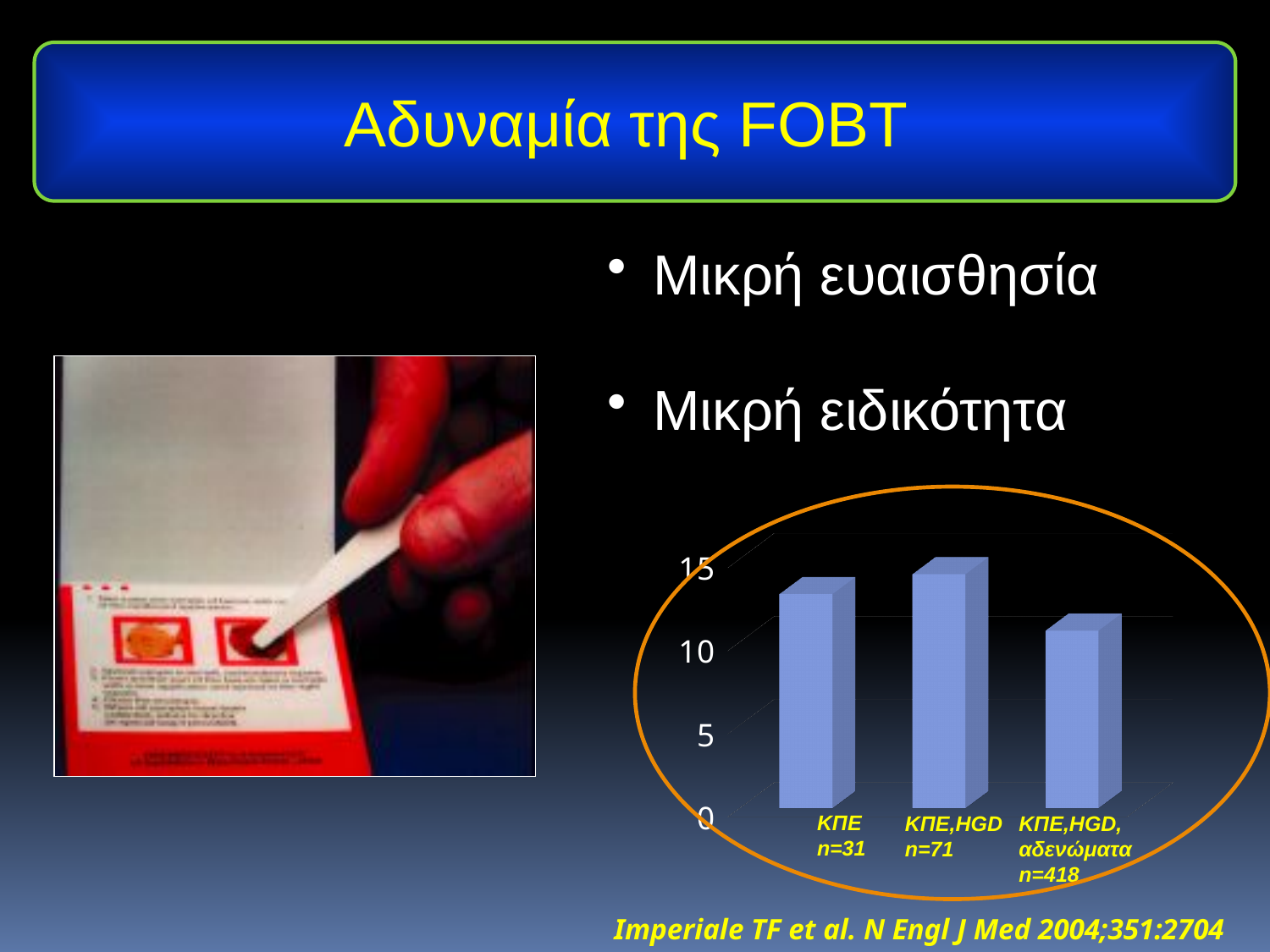
Is the value for ΚΠΕ n=31 greater or less than 10? greater Which is larger, the value for ΚΠΕ,HGD n=71 or the value for ΚΠΕ,HGD, αδενώματα n=418? ΚΠΕ,HGD n=71 Which category has the highest bar in the chart? ΚΠΕ,HGD n=71 What kind of chart is shown on the slide? bar chart Is the value for ΚΠΕ,HGD, αδενώματα n=418 greater or less than 15? less What source citation is given below the chart? Imperiale TF et al. N Engl J Med 2004;351:2704 How many categories are plotted in the bar chart? 3 Which is larger, the value for ΚΠΕ n=31 or the value for ΚΠΕ,HGD, αδενώματα n=418? ΚΠΕ n=31 Which category has the lowest bar in the chart? ΚΠΕ,HGD, αδενώματα n=418 What is the highest tick value shown on the vertical axis of the chart? 15